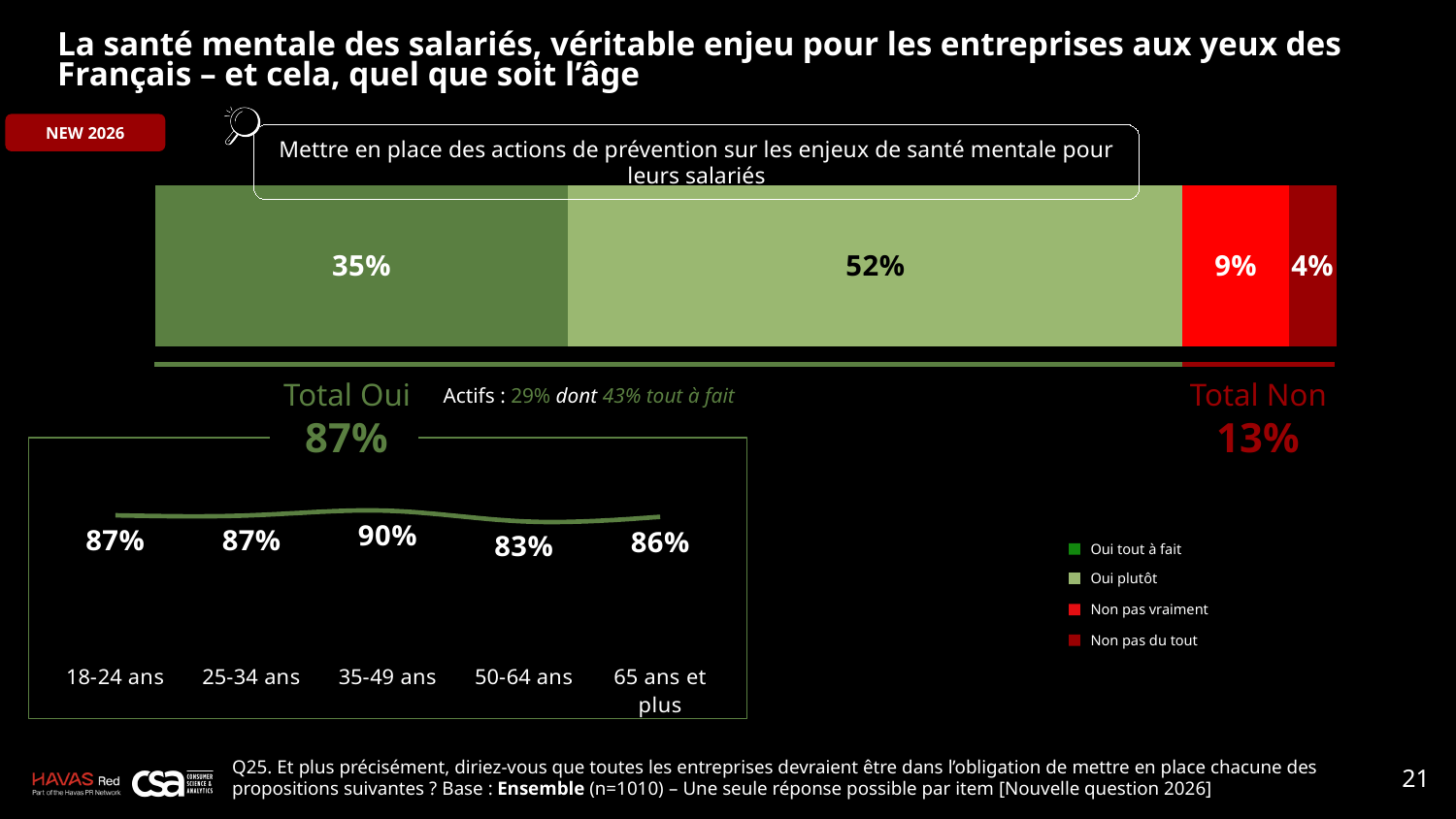
In the stacked bar chart at the top, what is the combined total of the two "Non" segments? 13% What type of chart is the age-group chart at the bottom left? line chart In the stacked bar chart at the top, which response category has the largest share? Oui plutôt In the age-group chart at the bottom left, what is the value for 35-49 ans? 90% In the age-group chart at the bottom left, is the value for 65 ans et plus larger or smaller than the value for 50-64 ans? larger In the age-group chart at the bottom left, how many age groups are shown? 5 In the age-group chart at the bottom left, which age group has the lowest value? 50-64 ans In the stacked bar chart at the top, what percentage answered "Oui plutôt"? 52% In the stacked bar chart at the top, what percentage answered "Non pas du tout"? 4% In the stacked bar chart at the top, what is the difference between the "Oui plutôt" and "Oui tout à fait" shares? 17 percentage points How many series does the legend of the stacked bar chart list? 4 In the stacked bar chart at the top, what percentage answered "Oui tout à fait"? 35%